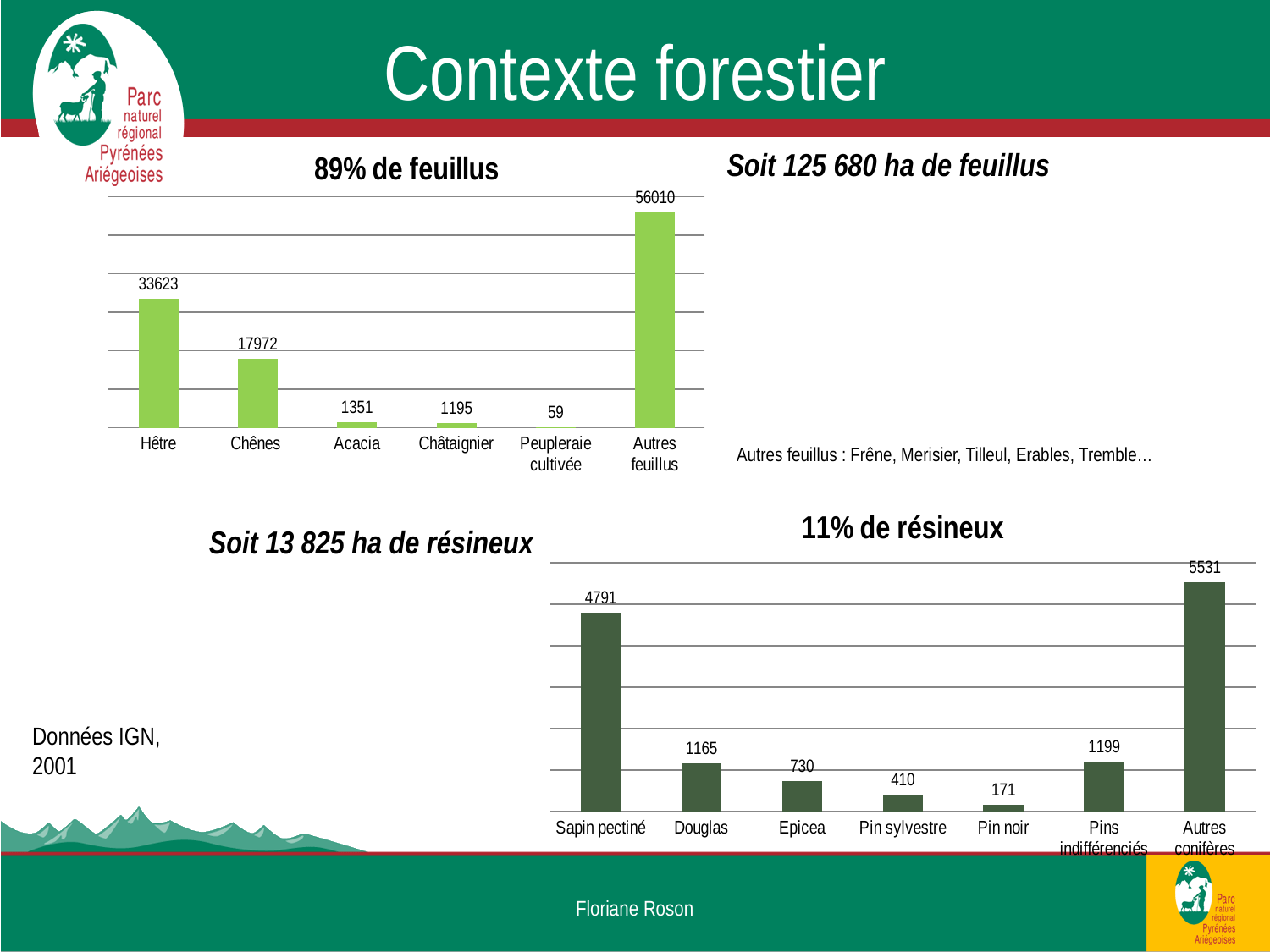
In the '11% de résineux' chart, how many categories are shown? 7 What type of chart is the '11% de résineux' chart? Bar chart In the '11% de résineux' chart, what is the difference between the values for Autres conifères and Sapin pectiné? 740 In the '89% de feuillus' chart, how many categories are shown? 6 In the '89% de feuillus' chart, what is the difference between the values for Hêtre and Chênes? 15651 In the '89% de feuillus' chart, which category has the highest value? Autres feuillus In the '11% de résineux' chart, what is the value for Sapin pectiné? 4791 In the '89% de feuillus' chart, which category has the lowest value? Peupleraie cultivée In the '89% de feuillus' chart, what is the value for Hêtre? 33623 In the '89% de feuillus' chart, which is larger, the value for Acacia or the value for Châtaignier? Acacia In the '11% de résineux' chart, which category has the lowest value? Pin noir In the '11% de résineux' chart, which category has the highest value? Autres conifères